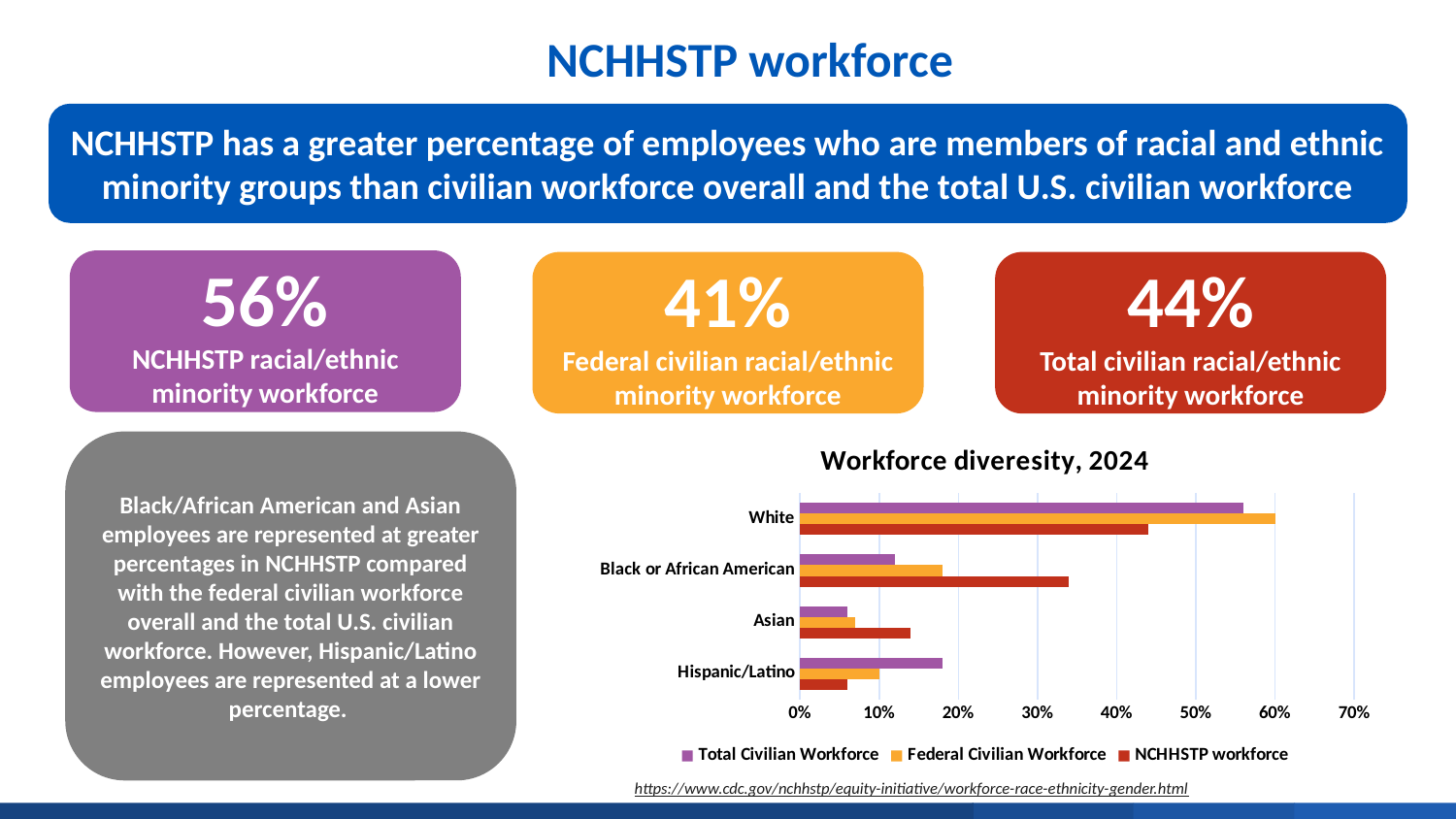
Is the NCHHSTP workforce value for White greater or less than 50%? less Which category has the lowest value for the NCHHSTP workforce series? Hispanic/Latino Is the Federal Civilian Workforce value for White greater or less than 50%? greater For Hispanic/Latino, which is larger: the Total Civilian Workforce value or the NCHHSTP workforce value? Total Civilian Workforce Is the NCHHSTP workforce value for Black or African American greater or less than 30%? greater How many racial/ethnic categories are plotted on the chart? 4 Which category has the highest value for the NCHHSTP workforce series? White What is the title of the chart? Workforce diveresity, 2024 How many series does the legend of the chart list? 3 For Black or African American, which is larger: the NCHHSTP workforce value or the Federal Civilian Workforce value? NCHHSTP workforce What colour represents the NCHHSTP workforce series in the chart? red What kind of chart is shown on the slide? bar chart